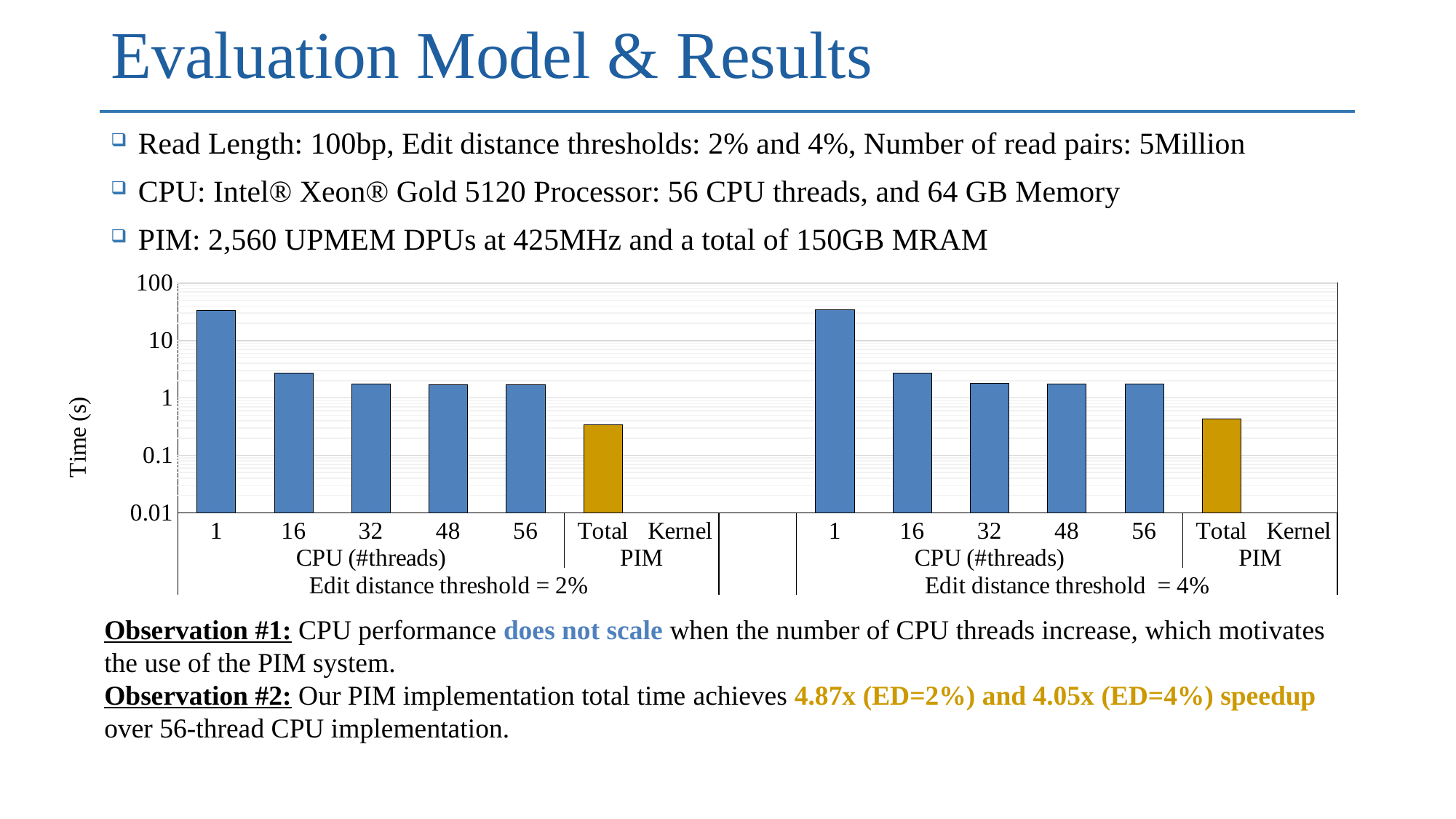
In the 'Edit distance threshold = 2%' group, which CPU thread count has the highest time? 1 What kind of chart is shown on the slide? bar chart At edit distance threshold = 2%, which is larger: the PIM Total time or the CPU 56-thread time? CPU 56-thread time In the 'Edit distance threshold = 2%' group, does the CPU time rise or fall as the number of threads increases from 1 to 56? fall In the 'Edit distance threshold = 4%' group, which CPU thread count has the highest time? 1 Is the time for CPU with 16 threads at edit distance threshold = 4% greater or less than 1? greater Is the time for CPU with 1 thread at edit distance threshold = 2% greater or less than 10? greater At edit distance threshold = 4%, which is larger: the time for CPU with 1 thread or CPU with 16 threads? CPU with 1 thread Is the PIM Total time at edit distance threshold = 2% greater or less than 1? less How many CPU thread counts are plotted in each edit distance threshold group? 5 What is the label of the vertical axis of the chart? Time (s)